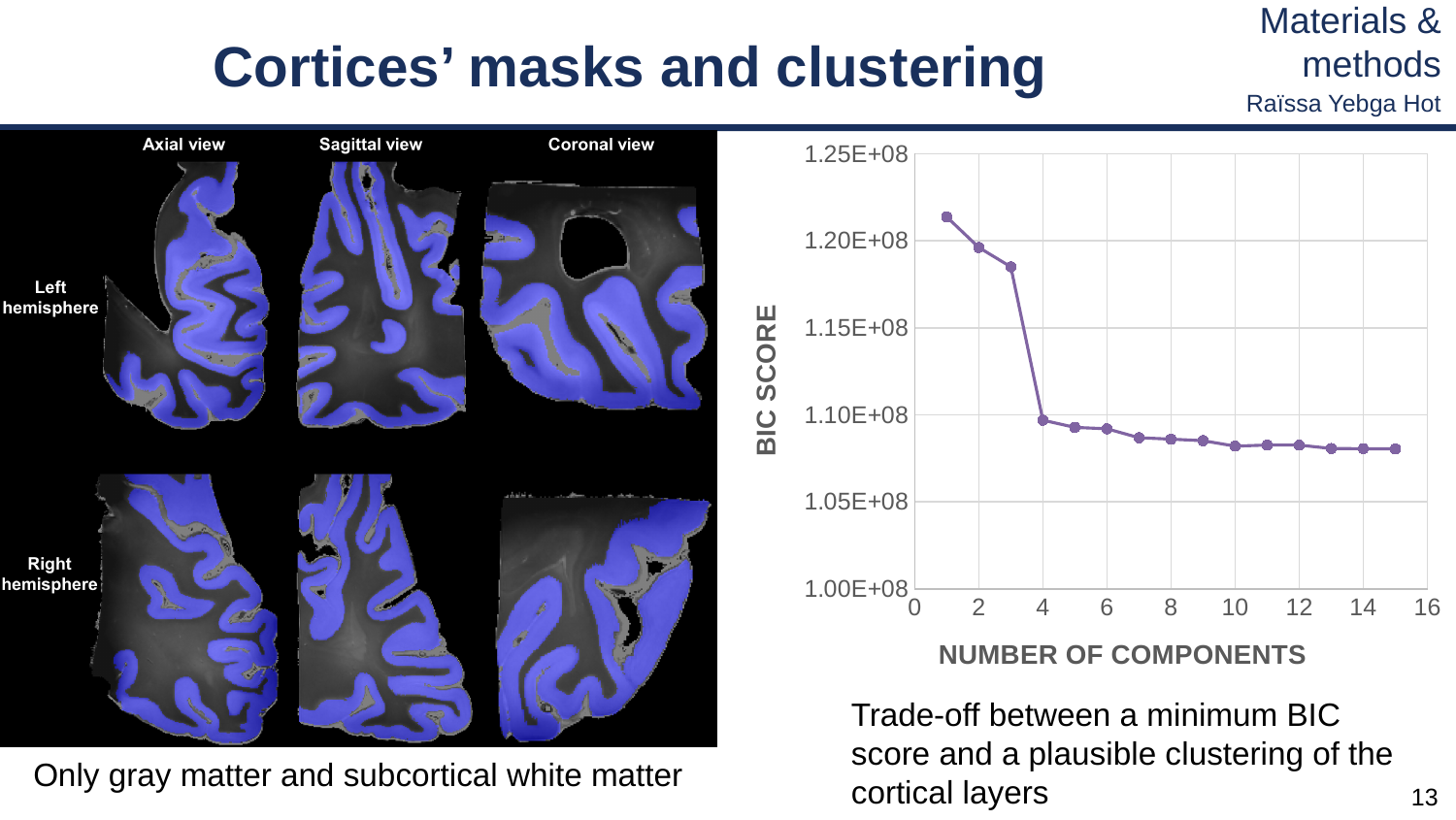
What is the label of the x axis on the chart? NUMBER OF COMPONENTS Do the BIC score values rise or fall as the number of components increases? fall Which has the larger BIC score: 1 component or 4 components? 1 component What is the label of the y axis on the chart? BIC SCORE Is the BIC score for 15 components greater or less than 1.10E+08? less At which number of components is the BIC score highest? 1 Which has the larger BIC score: 3 components or 4 components? 3 components What kind of chart is shown on the right of the slide? line chart How many data points are plotted on the BIC score chart? 15 Is the BIC score for 3 components greater or less than 1.15E+08? greater Is the BIC score for 1 component greater or less than 1.20E+08? greater